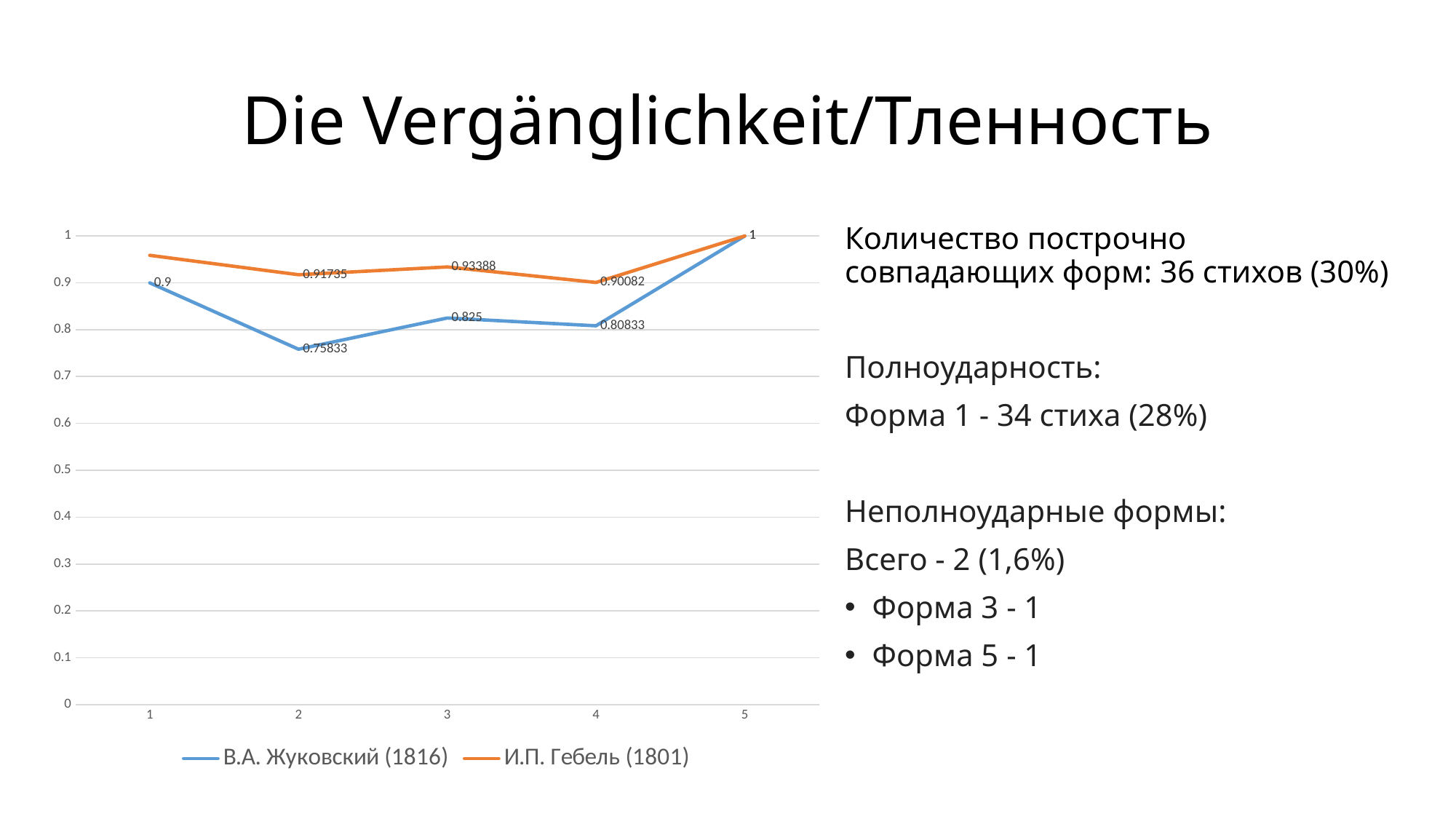
Is the value for И.П. Гебель (1801) at point 1 greater or less than 0.9? greater Which series has the higher value at point 2, В.А. Жуковский (1816) or И.П. Гебель (1801)? И.П. Гебель (1801) How many points are plotted along the x axis for each series? 5 How many series does the chart legend list? 2 What kind of chart is shown on the slide? line chart What is the value for И.П. Гебель (1801) at point 3? 0.93388 At which point does В.А. Жуковский (1816) reach its lowest value? 2 What is the value for В.А. Жуковский (1816) at point 2? 0.75833 Which series is drawn in orange in the chart? И.П. Гебель (1801) What is the value for В.А. Жуковский (1816) at point 1? 0.9 What is the value for И.П. Гебель (1801) at point 4? 0.90082 Does the value for В.А. Жуковский (1816) rise or fall from point 4 to point 5? rise